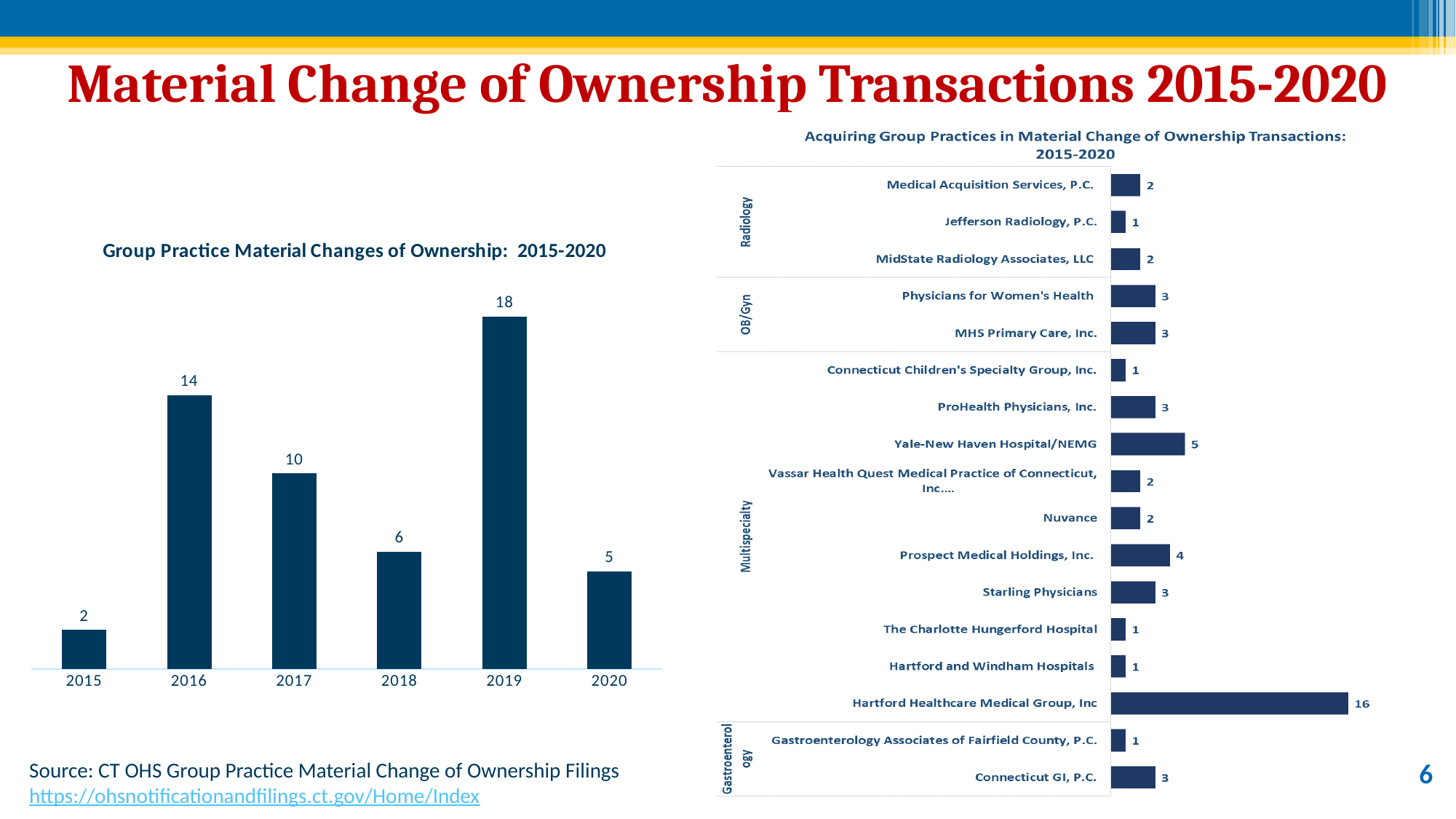
In the 'Group Practice Material Changes of Ownership: 2015-2020' chart, what is the difference between the values for 2016 and 2018? 8 In the 'Group Practice Material Changes of Ownership: 2015-2020' chart, how many years are shown on the x axis? 6 In the 'Acquiring Group Practices in Material Change of Ownership Transactions: 2015-2020' chart, which acquiring group practice has the highest value? Hartford Healthcare Medical Group, Inc In the 'Group Practice Material Changes of Ownership: 2015-2020' chart, which year has the lowest value? 2015 In the 'Group Practice Material Changes of Ownership: 2015-2020' chart, what is the value for 2019? 18 What kind of chart is the 'Group Practice Material Changes of Ownership: 2015-2020' chart? bar chart In the 'Group Practice Material Changes of Ownership: 2015-2020' chart, do the values rise or fall from 2019 to 2020? fall In the 'Group Practice Material Changes of Ownership: 2015-2020' chart, which year has the highest value? 2019 In the 'Acquiring Group Practices in Material Change of Ownership Transactions: 2015-2020' chart, what is the value for Yale-New Haven Hospital/NEMG? 5 In the 'Acquiring Group Practices in Material Change of Ownership Transactions: 2015-2020' chart, what is the value for Hartford Healthcare Medical Group, Inc? 16 In the 'Acquiring Group Practices in Material Change of Ownership Transactions: 2015-2020' chart, which is larger, the value for Prospect Medical Holdings, Inc. or the value for Nuvance? Prospect Medical Holdings, Inc. In the 'Acquiring Group Practices in Material Change of Ownership Transactions: 2015-2020' chart, how many acquiring group practices are listed? 17